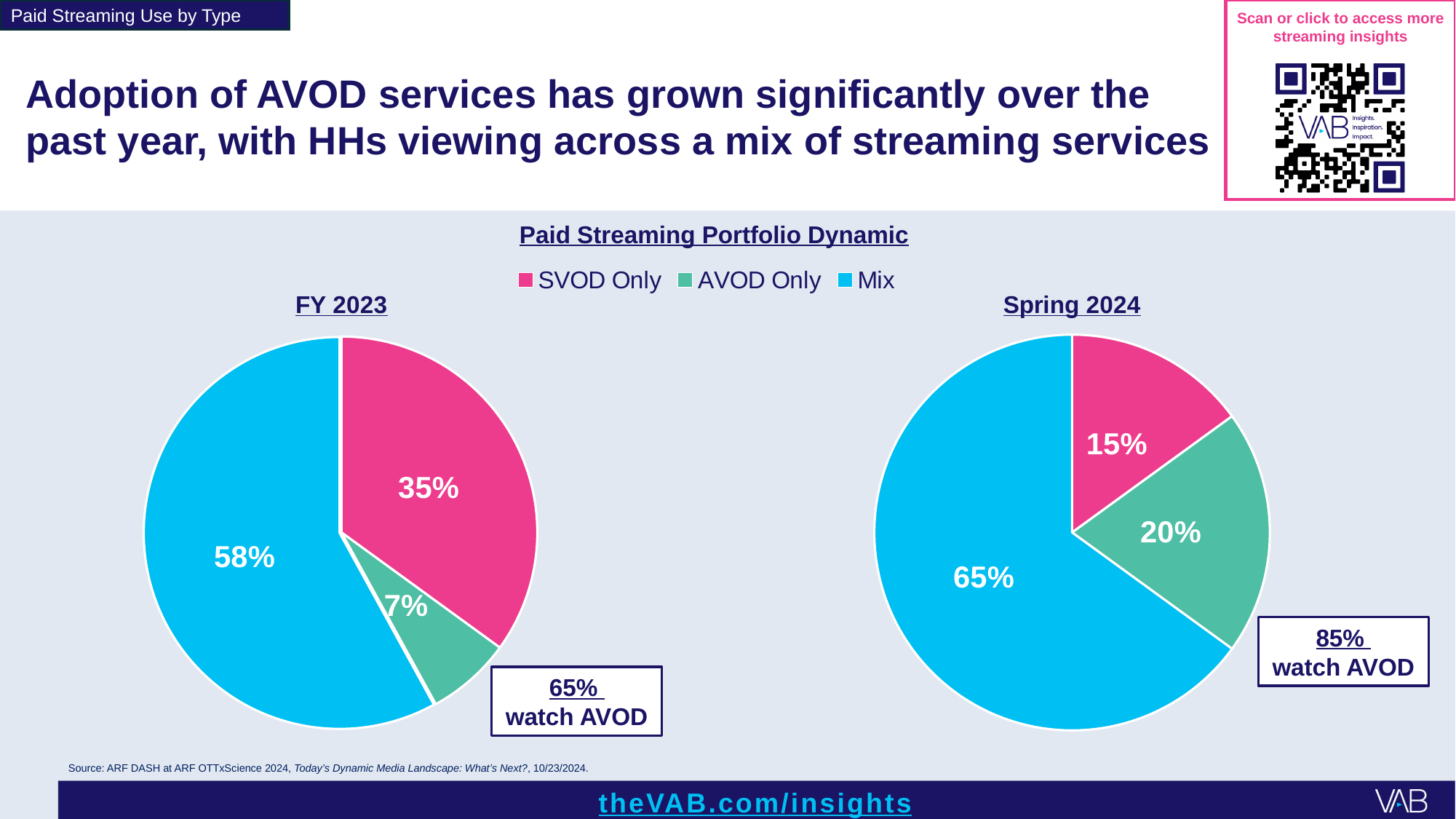
In the Spring 2024 pie chart, which category has the smallest share? SVOD Only In the Spring 2024 pie chart, what share is Mix? 65% How many slices does the FY 2023 pie chart have? 3 What is the difference between the SVOD Only share in FY 2023 and in Spring 2024? 20 percentage points How many entries does the legend list? 3 What type of chart is used for FY 2023 and Spring 2024? Pie chart In the Spring 2024 pie chart, which is larger: AVOD Only or SVOD Only? AVOD Only In the FY 2023 pie chart, which category has the largest share? Mix In the FY 2023 pie chart, what share is SVOD Only? 35% In the Spring 2024 pie chart, what share is AVOD Only? 20% What colour represents Mix in the pie charts? Blue In the FY 2023 pie chart, what share is AVOD Only? 7%